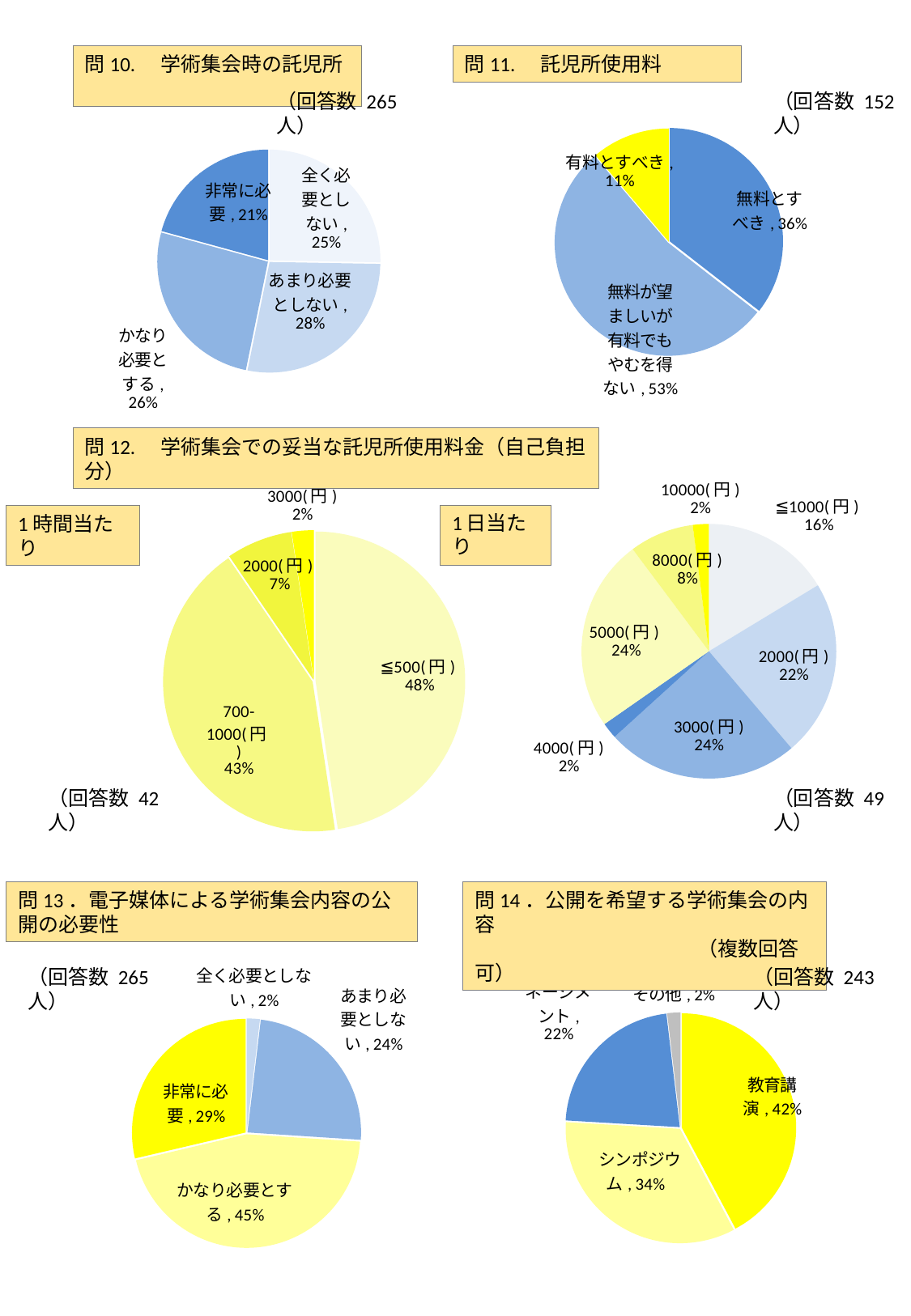
In the 問13 pie chart, what percentage answered 全く必要としない? 2% In the 問12 1時間当たり pie chart, what percentage chose 2000(円)? 7% In the 問14 公開を希望する学術集会の内容 pie chart, what is the difference in percentage points between 教育講演 and シンポジウム? 8 In the 問12 1時間当たり pie chart, which price range has the largest share? ≦500(円) In the 問12 1日当たり pie chart, what percentage chose 8000(円)? 8% How many categories are shown in the 問12 1日当たり pie chart? 7 In the 問10 学術集会時の託児所 pie chart, which response has the smallest share? 非常に必要 In the 問11 託児所使用料 pie chart, what is the difference in percentage points between 無料とすべき and 有料とすべき? 25 What kind of chart is used for 問11 託児所使用料? Pie chart In the 問10 学術集会時の託児所 pie chart, what percentage of respondents answered あまり必要としない? 28% In the 問11 託児所使用料 pie chart, what share of respondents chose 無料が望ましいが有料でもやむを得ない? 53% In the 問13 pie chart, which is larger: かなり必要とする or 非常に必要? かなり必要とする